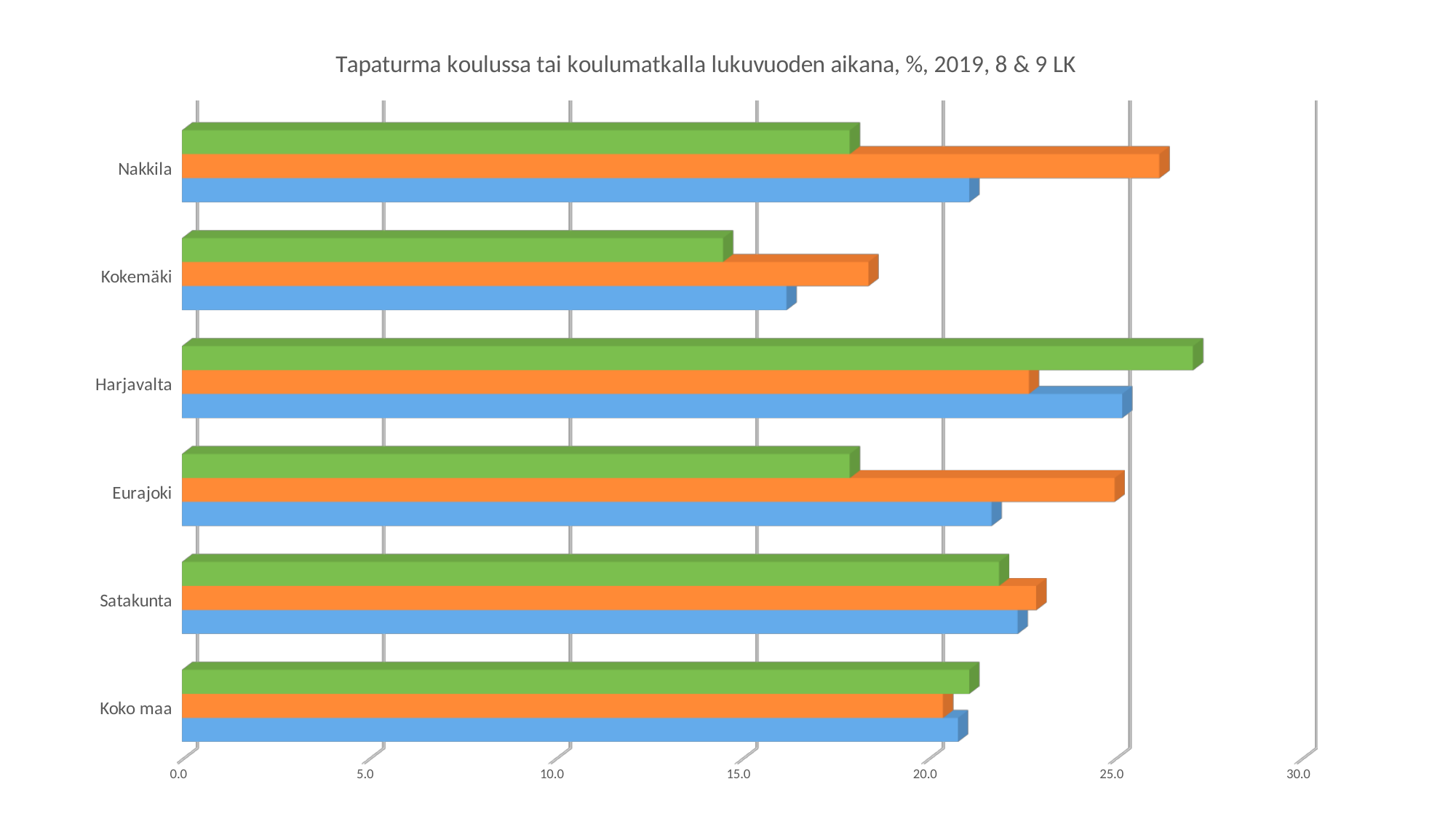
Which category has the shortest orange bar? Kokemäki What kind of chart is shown on the slide? bar chart Is the value of the green bar for Kokemäki greater or less than 15.0? less Which category has the longest blue bar? Harjavalta What is the title of the chart? Tapaturma koulussa tai koulumatkalla lukuvuoden aikana, %, 2019, 8 & 9 LK Is the value of the green bar for Harjavalta greater or less than 25.0? greater For Nakkila, which bar is longer, the orange bar or the green bar? orange How many categories (areas) are shown on the vertical axis of the chart? 6 Is the value of the orange bar for Nakkila greater or less than 25.0? greater For Harjavalta, which bar is longer, the green bar or the orange bar? green Which category has the longest green bar? Harjavalta Which category has the shortest green bar? Kokemäki